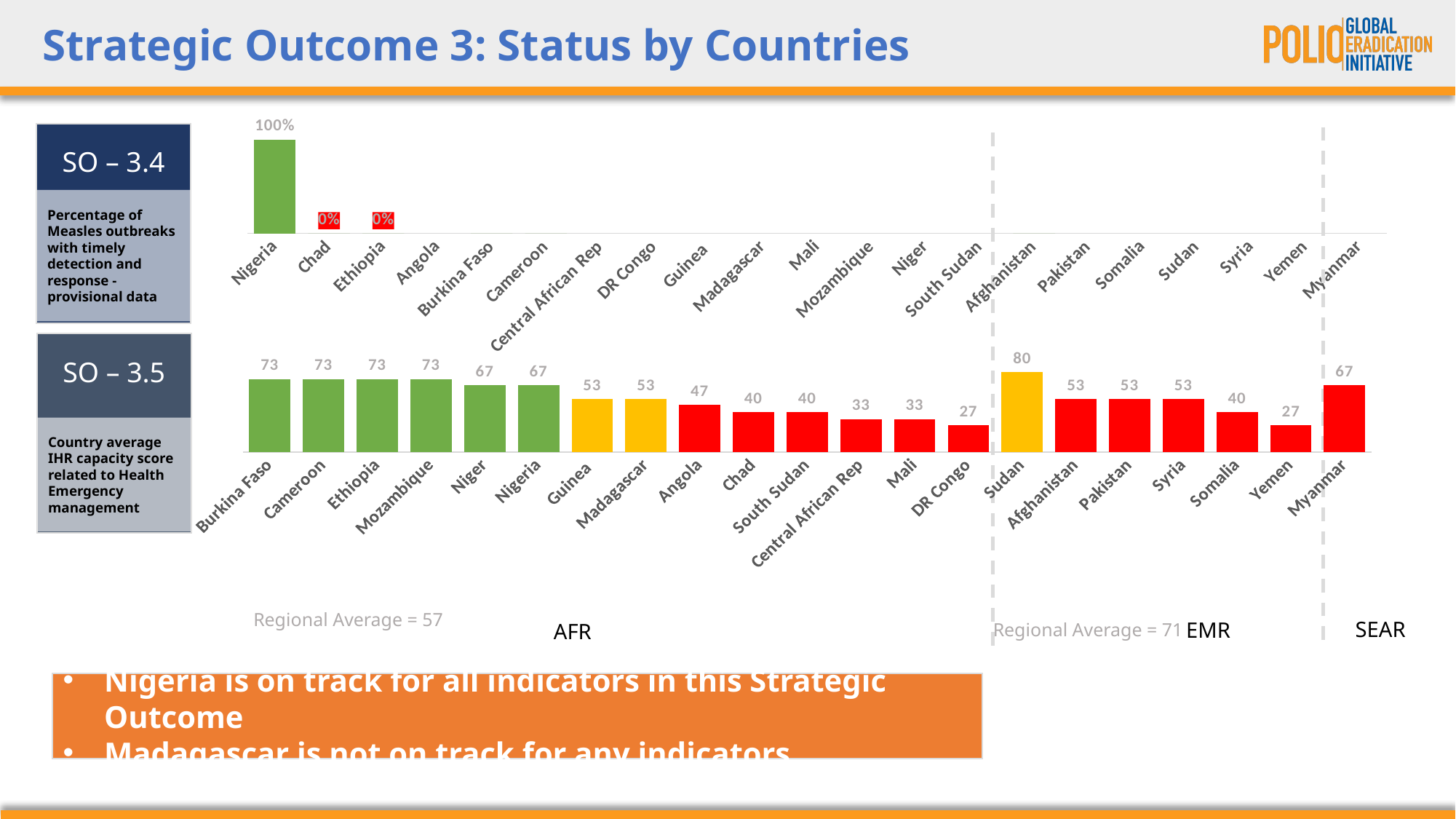
In the SO – 3.5 chart (bottom), how many countries are shown on the x axis? 21 In the SO – 3.4 chart (top), what is the value for Nigeria? 100% In the SO – 3.5 chart (bottom), what is the value for Myanmar? 67 In the SO – 3.5 chart (bottom), what is the difference between the values for Sudan and DR Congo? 53 In the SO – 3.5 chart (bottom), what is the value for Central African Rep? 33 In the SO – 3.5 chart (bottom), which is larger, the value for Angola or the value for Chad? Angola What kind of chart is the SO – 3.5 chart (bottom)? Bar chart In the SO – 3.5 chart (bottom), what is the value for Sudan? 80 In the SO – 3.5 chart (bottom), which country has the highest value? Sudan In the SO – 3.4 chart (top), which country has the highest value? Nigeria In the SO – 3.4 chart (top), what is the value for Chad? 0% In the SO – 3.5 chart (bottom), what is the regional average shown for AFR? 57